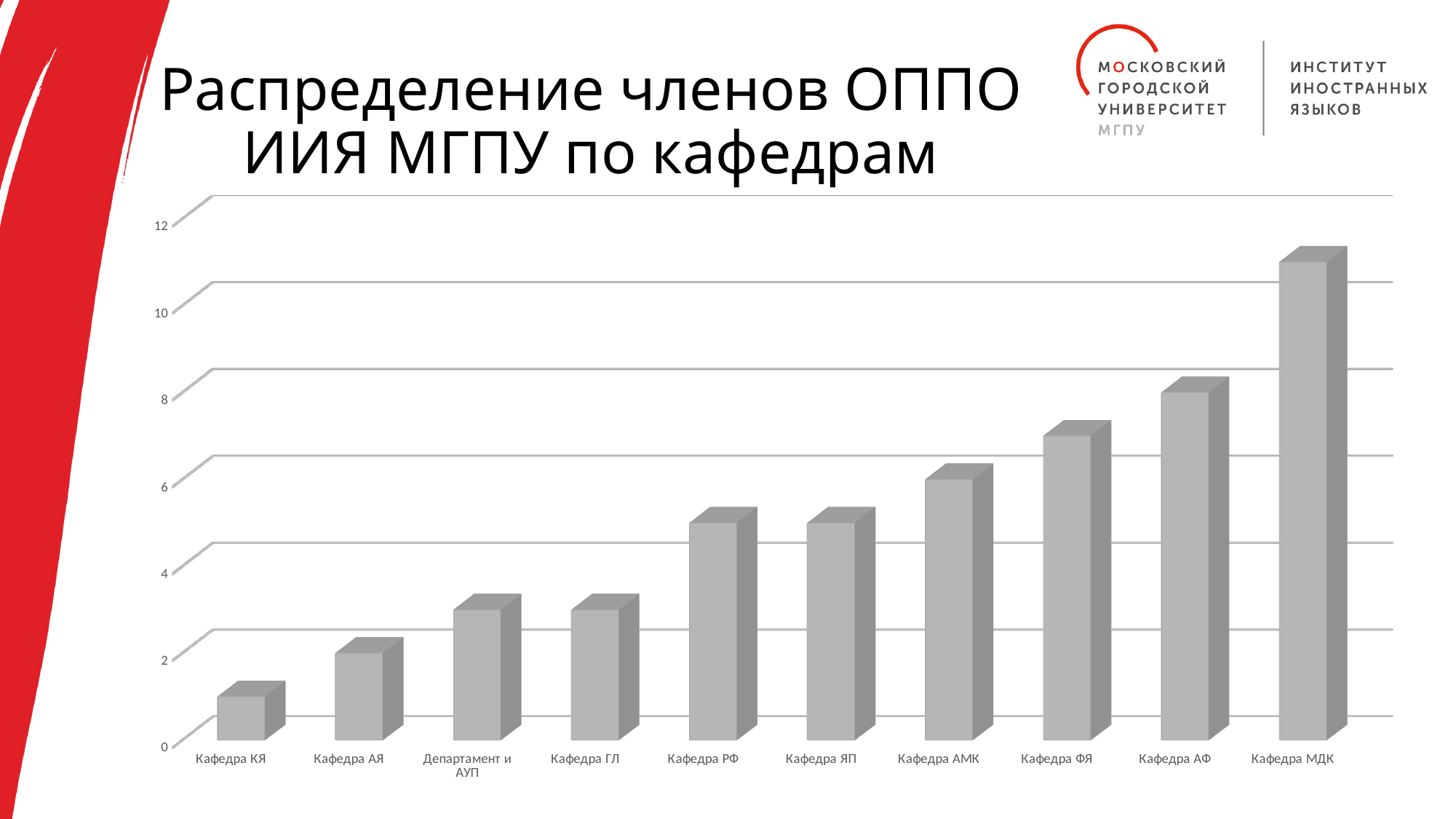
What is the title of the slide containing the chart? Распределение членов ОППО ИИЯ МГПУ по кафедрам Is the value for Кафедра КЯ greater or less than 2? less Is the value for Кафедра ГЛ greater or less than 4? less Is the value for Кафедра ФЯ greater or less than 6? greater What kind of chart is shown on the slide? bar chart Do the bar values generally rise or fall from left to right along the x axis? rise Which category has the highest bar? Кафедра МДК Which category has the lowest bar? Кафедра КЯ Which is larger, the value for Кафедра МДК or the value for Кафедра АФ? Кафедра МДК How many categories are shown on the x axis? 10